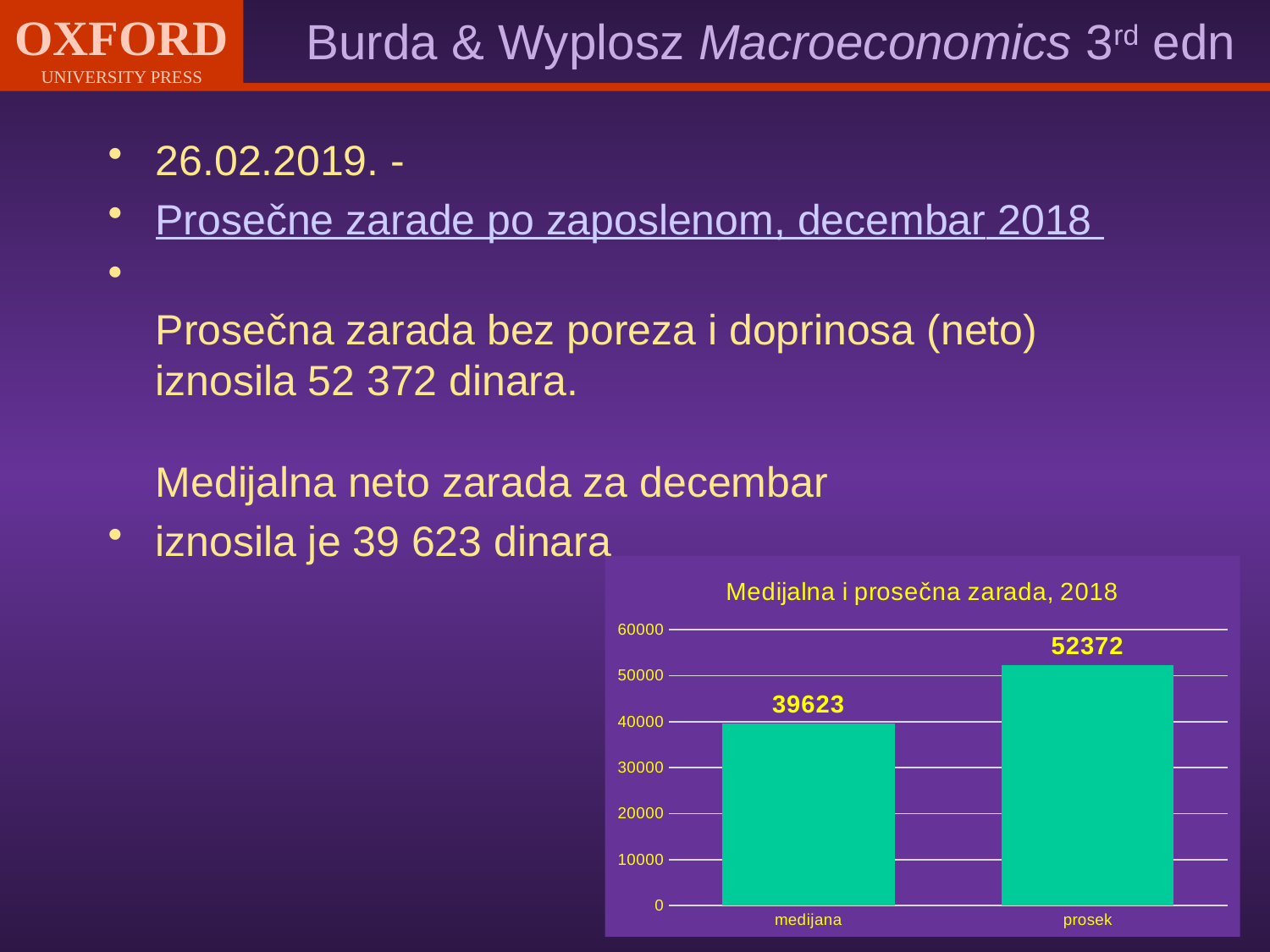
Which category has the highest value in the chart? prosek Is the value for medijana greater or less than 40000? less What is the title of the chart? Medijalna i prosečna zarada, 2018 What is the difference between the values for prosek and medijana? 12749 How many categories are shown in the chart? 2 What kind of chart is shown on the slide? bar chart Which is larger, the value for medijana or the value for prosek? prosek Is the value for prosek greater or less than 50000? greater What is the value for medijana in the chart? 39623 What is the highest value shown on the chart's vertical axis? 60000 What is the value for prosek in the chart? 52372 Which category has the lowest value in the chart? medijana